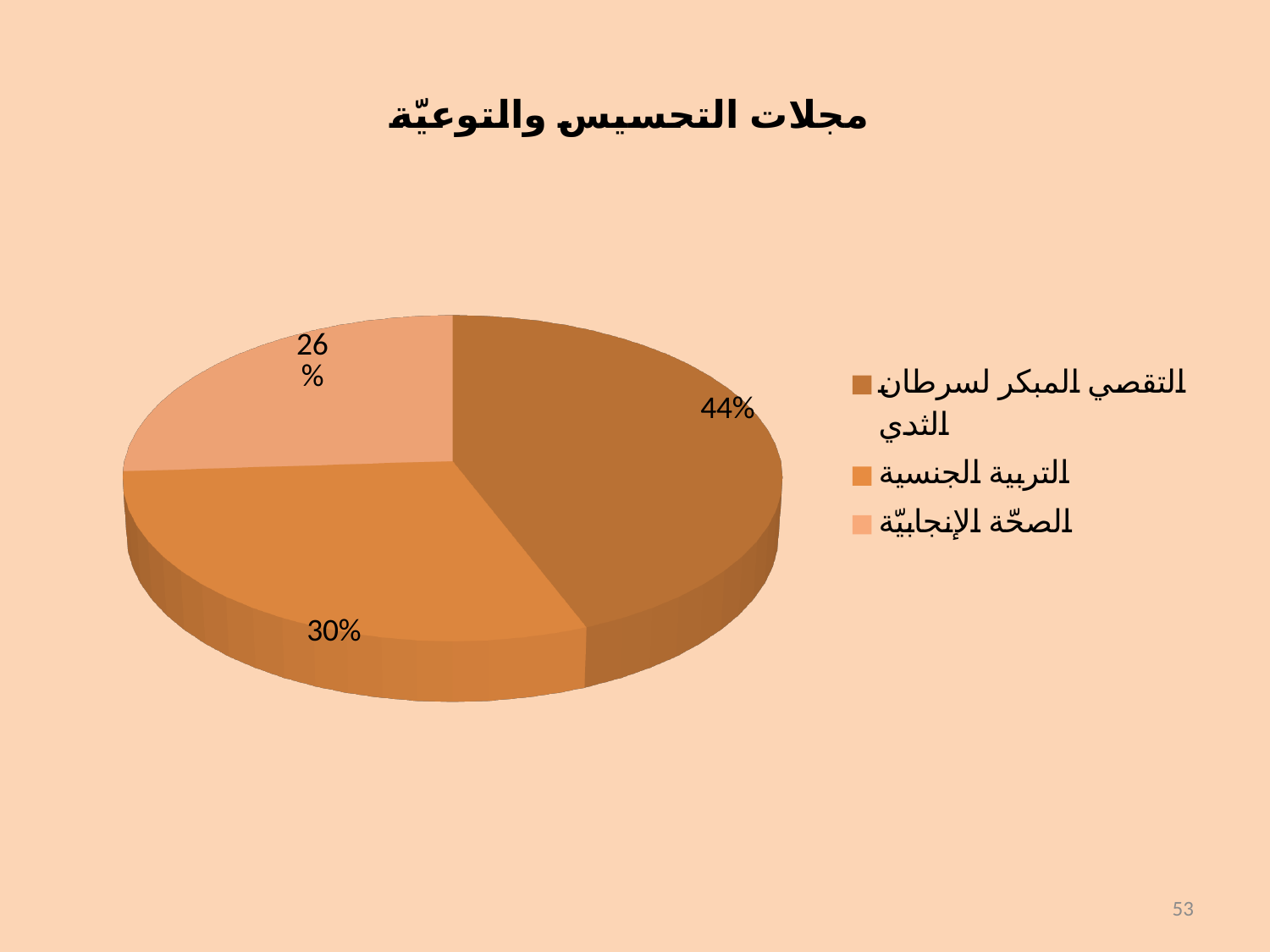
What is the difference in percentage points between التقصي المبكر لسرطان الثدي and الصحّة الإنجابيّة? 18 Which is larger, the share for التربية الجنسية or the share for الصحّة الإنجابيّة? التربية الجنسية What share of the pie does التربية الجنسية represent? 30% What kind of chart is shown on the slide? pie chart How many entries does the legend list? 3 What percentage is shown for التربية الجنسية? 30% How many slices does the pie chart have? 3 What percentage is shown for التقصي المبكر لسرطان الثدي? 44% Which category has the largest share of the pie? التقصي المبكر لسرطان الثدي What is the title of the chart? مجلات التحسيس والتوعيّة Which category has the smallest share of the pie? الصحّة الإنجابيّة What percentage is shown for الصحّة الإنجابيّة? 26%